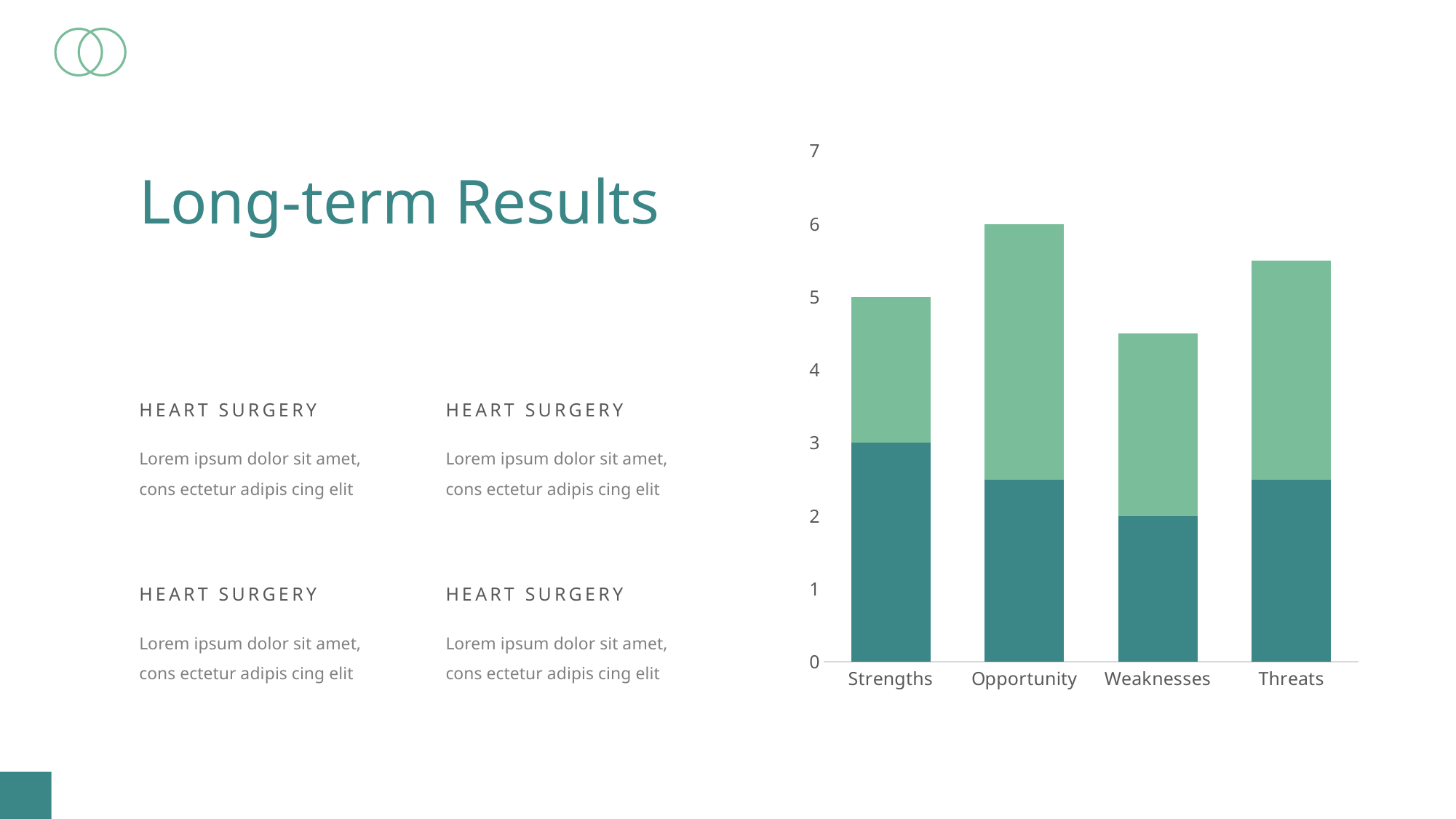
Which category has the tallest dark teal bottom segment? Strengths What is the value of the dark teal bottom segment for Strengths? 3 What is the total height of the stacked bar for Strengths? 5 Which category has the tallest stacked bar overall? Opportunity Which category has the shortest stacked bar overall? Weaknesses Which stacked bar is taller overall, Strengths or Threats? Threats What is the value of the dark teal bottom segment for Weaknesses? 2 What kind of chart is shown on the slide? bar chart How many categories are shown on the x axis of the chart? 4 Is the total height of the Threats bar greater or less than 5? greater Is the total height of the Weaknesses bar greater or less than 5? less What is the total height of the stacked bar for Opportunity? 6